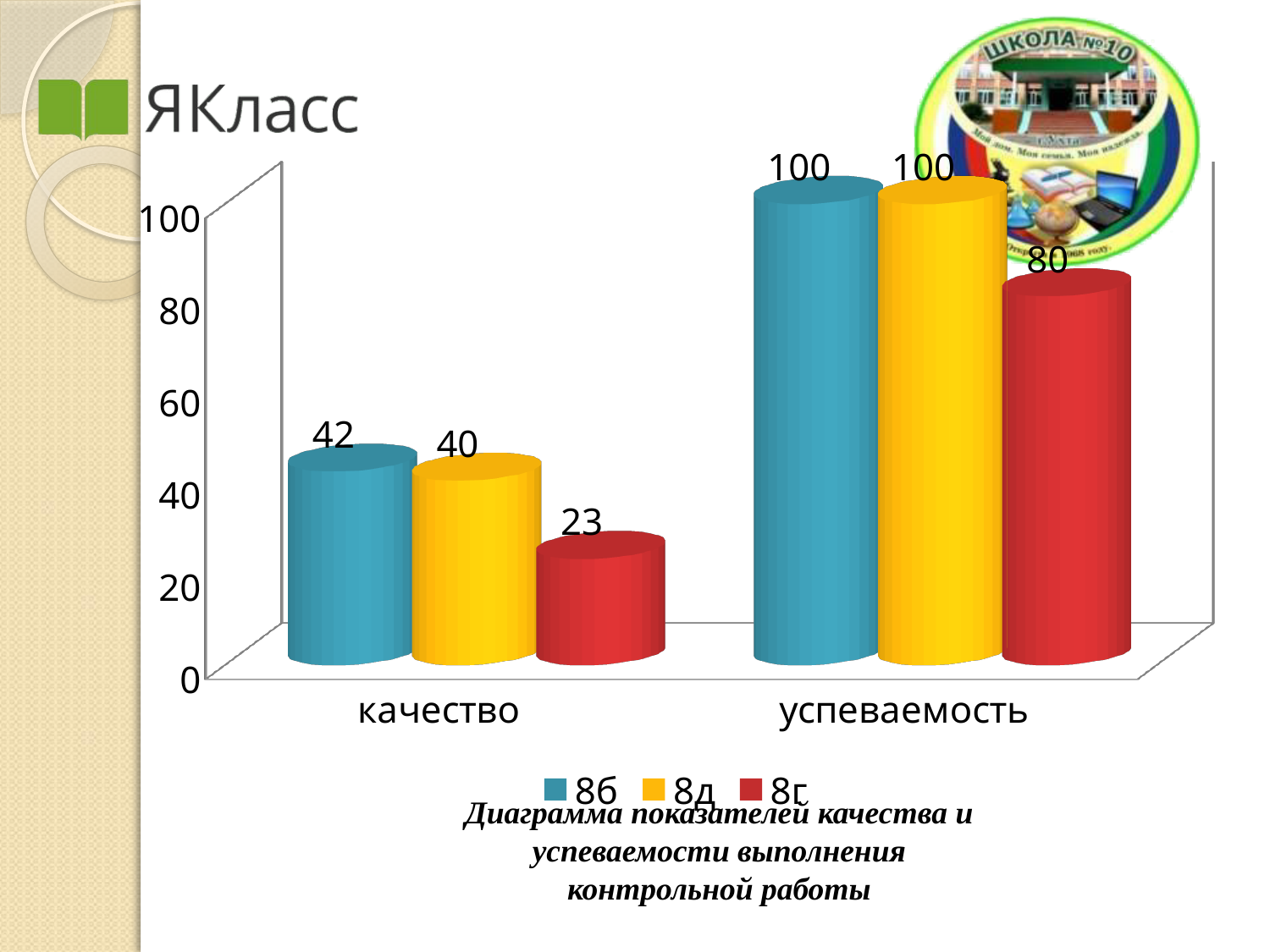
What kind of chart is shown on the slide? bar chart Which is larger: the 8б value for качество or the 8д value for качество? 8б What is the value for 8г in the успеваемость category? 80 What is the value for 8б in the качество category? 42 What is the difference between the 8д and 8г values in the успеваемость category? 20 What is the value for 8д in the качество category? 40 What is the value for 8б in the успеваемость category? 100 Which series has the lowest value in the качество category? 8г What is the difference between the 8б and 8г values in the качество category? 19 How many series does the legend list? 3 How many categories are shown on the x axis? 2 Which series is shown in red in the legend? 8г